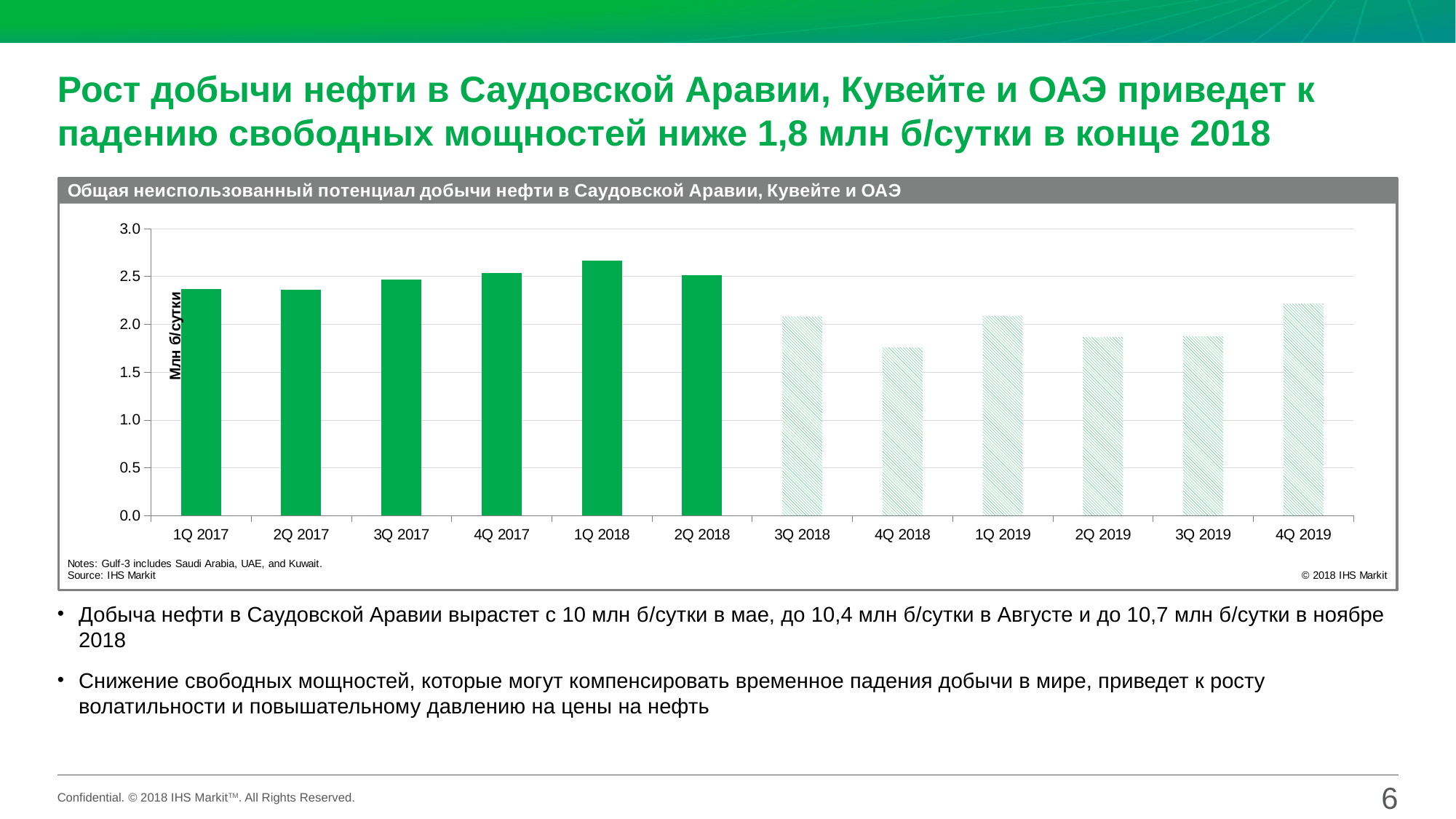
What unit is shown on the y axis of the chart? Млн б/сутки Which quarter has the lowest value in the chart? 4Q 2018 Is the value for 4Q 2019 greater or less than 2.0? greater Is the value for 1Q 2018 greater or less than 2.5? greater Which is larger, the value for 4Q 2017 or the value for 3Q 2018? 4Q 2017 What is the title of the chart? Общая неиспользованный потенциал добычи нефти в Саудовской Аравии, Кувейте и ОАЭ Do the values rise or fall from 2Q 2017 to 1Q 2018? rise How many quarters are shown on the x axis of the chart? 12 What kind of chart is shown on the slide? Bar chart Is the value for 4Q 2018 greater or less than 2.0? less Which quarter has the highest value in the chart? 1Q 2018